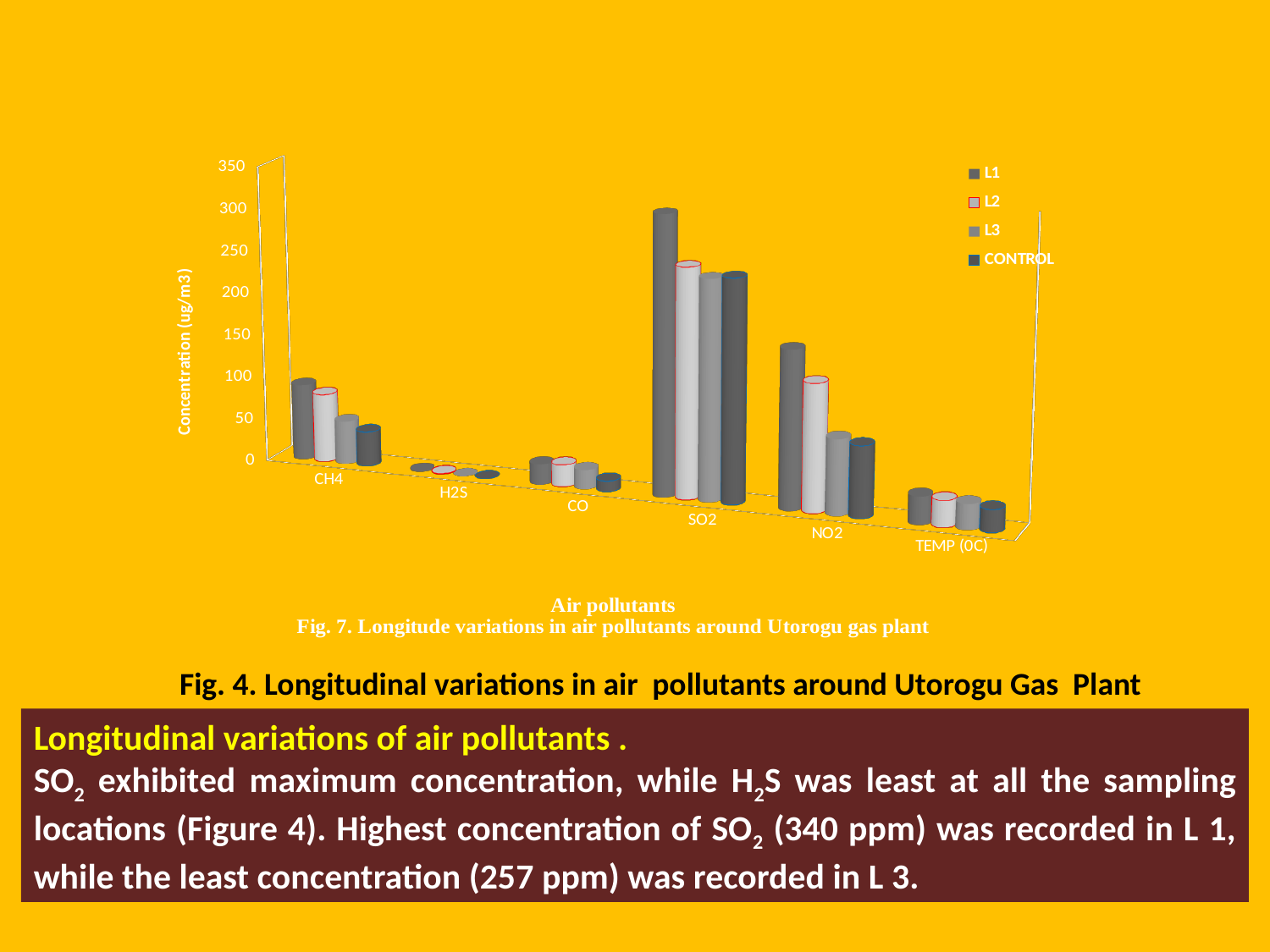
Is the L1 value for CH4 greater or less than 150? less For SO2, which series has the tallest bar? L1 Which is larger for CH4, the L1 value or the CONTROL value? L1 How many air pollutant categories are shown on the x axis? 6 Is the L1 value for NO2 greater or less than 50? greater How many series does the legend list? 4 Which air pollutant has the highest concentration across the sampling locations? SO2 Which is larger, the L1 value for SO2 or the L1 value for NO2? SO2 Which air pollutant has the lowest concentration across the sampling locations? H2S What kind of chart is shown on the slide? bar chart What is the title of the vertical axis? Concentration (ug/m3) Is the L1 value for SO2 greater or less than 200? greater